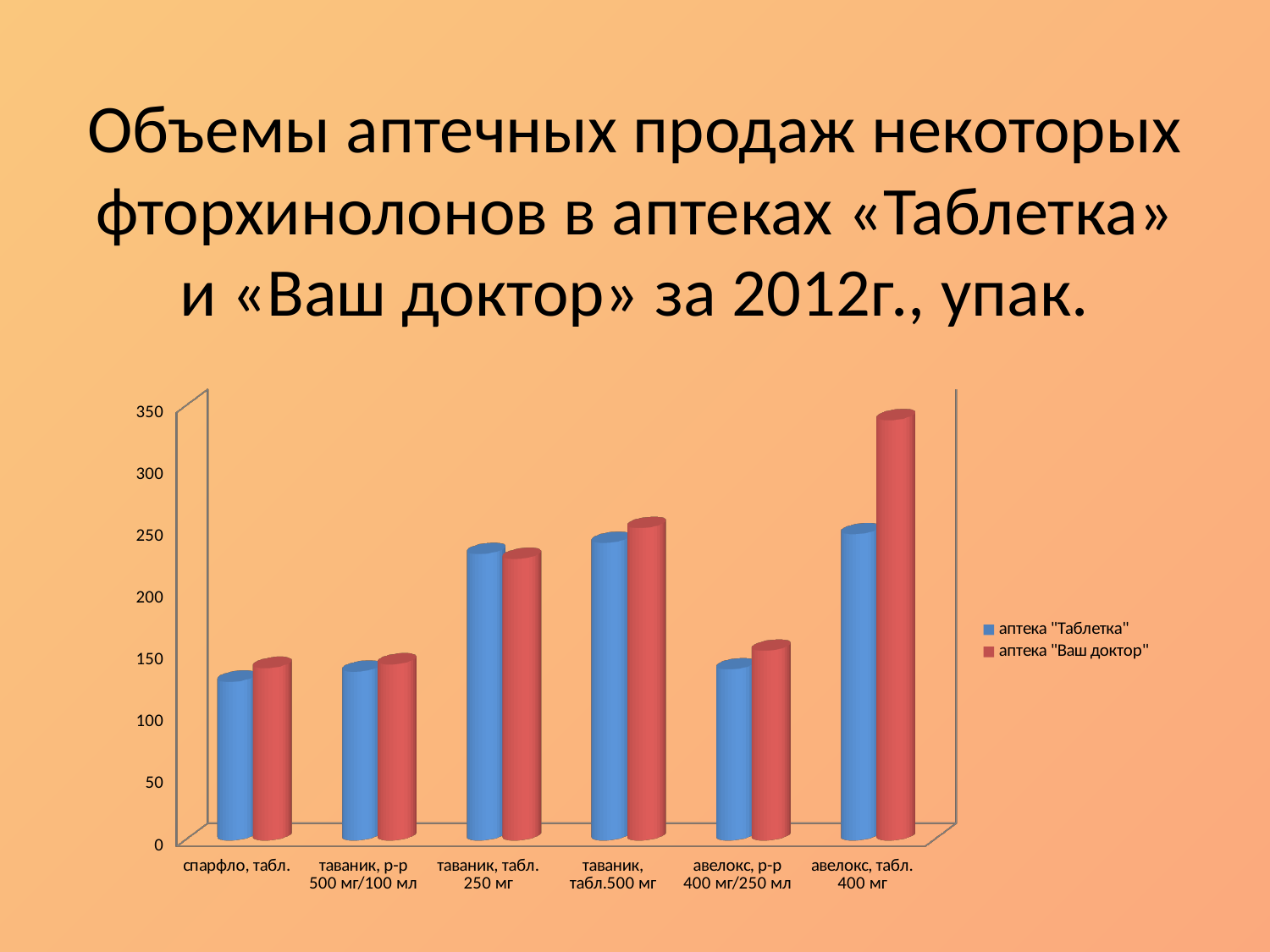
What year do the sales volumes in the chart refer to, according to the slide title? 2012 For авелокс, табл. 400 мг, which pharmacy has the larger value: аптека "Таблетка" or аптека "Ваш доктор"? аптека "Ваш доктор" Is the value for спарфло, табл. at аптека "Таблетка" greater or less than 150? less Is the value for авелокс, р-р 400 мг/250 мл at аптека "Ваш доктор" greater or less than 200? less Which category has the highest value for аптека "Ваш доктор"? авелокс, табл. 400 мг How many product categories are shown on the x axis of the chart? 6 For аптека "Таблетка", which is larger: авелокс, р-р 400 мг/250 мл or авелокс, табл. 400 мг? авелокс, табл. 400 мг Is the value for авелокс, табл. 400 мг at аптека "Ваш доктор" greater or less than 300? greater What kind of chart is shown on the slide? bar chart Which colour represents аптека "Ваш доктор" in the chart? red How many series does the chart legend list? 2